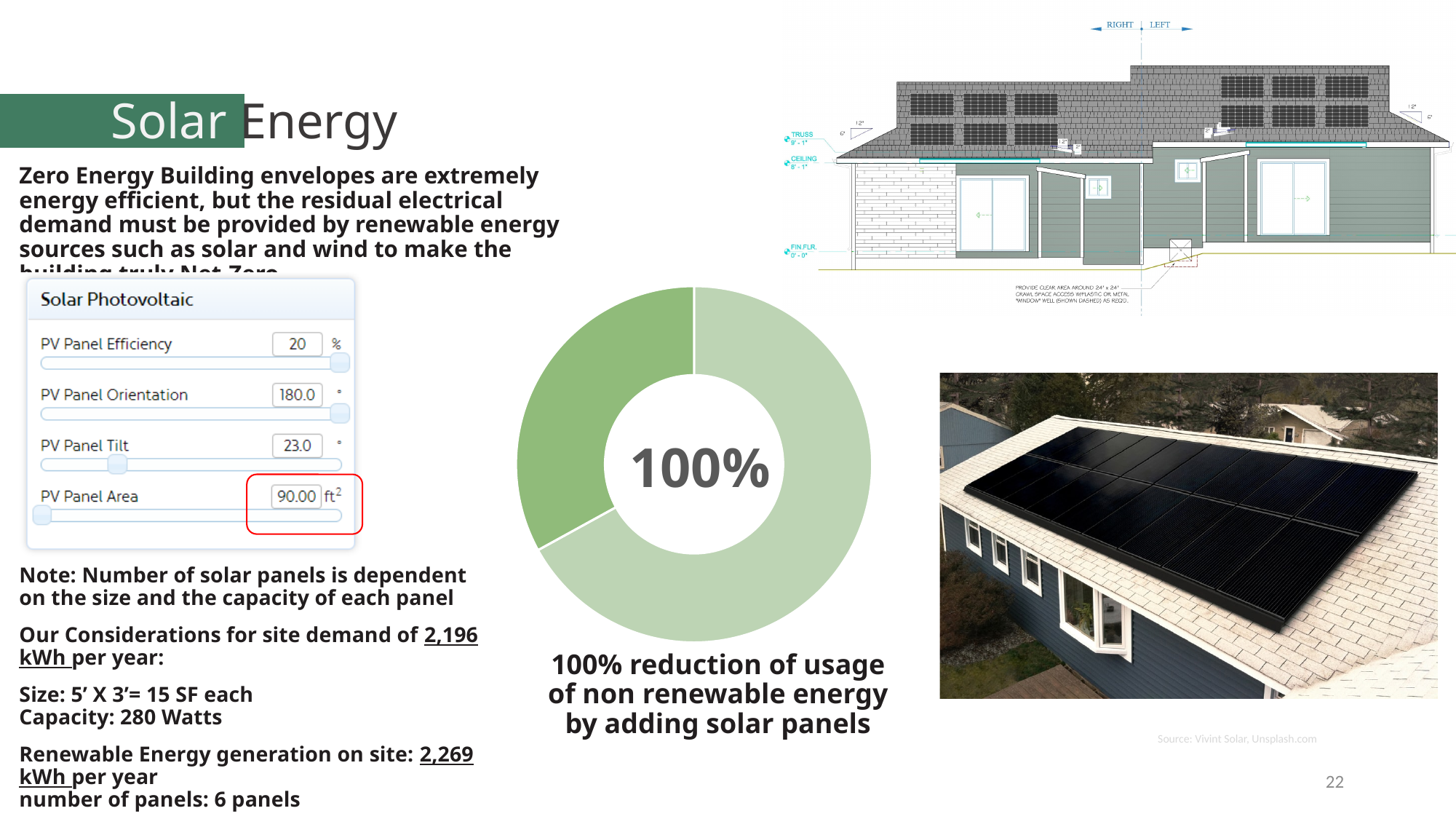
Does the donut chart have a legend? No How many slices does the donut chart have? 2 What kind of chart is shown in the centre of the slide? Donut (pie) chart What value is printed in the centre of the donut chart? 100% Which slice of the donut chart is the smallest? The dark green slice Which slice of the donut chart is larger, the dark green one or the light green one? The light green one What caption appears below the donut chart? 100% reduction of usage of non renewable energy by adding solar panels